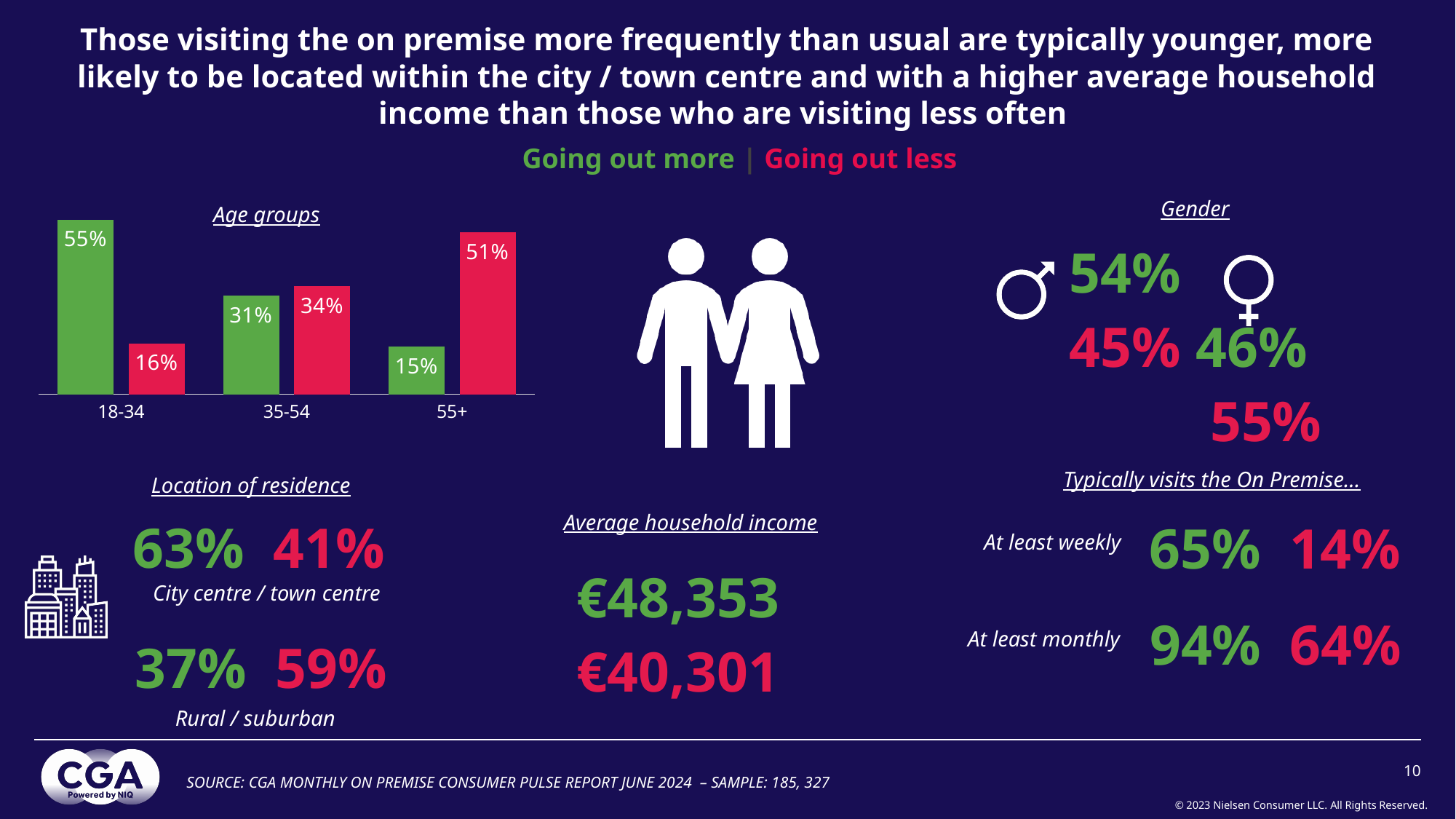
In the Age groups chart, what is the value for the 55+ age group among those going out more? 15% What type of chart is the Age groups chart? Bar chart In the Age groups chart, what is the value for the 18-34 age group among those going out more? 55% In the Age groups chart, what is the difference between the going out more and going out less values for the 18-34 age group? 39 percentage points In the Age groups chart, which age group has the highest value among those going out more? 18-34 In the Age groups chart, for the 35-54 age group, which is larger: the going out more value or the going out less value? Going out less In the Age groups chart, what is the value for the 55+ age group among those going out less? 51% In the Age groups chart, do the going out more values rise or fall as age increases from 18-34 to 55+? Fall In the Age groups chart, what is the difference between the going out less and going out more values for the 55+ age group? 36 percentage points In the Age groups chart, which age group has the lowest value among those going out less? 18-34 In the Age groups chart, what is the value for the 35-54 age group among those going out less? 34% How many age groups are shown in the Age groups chart? 3